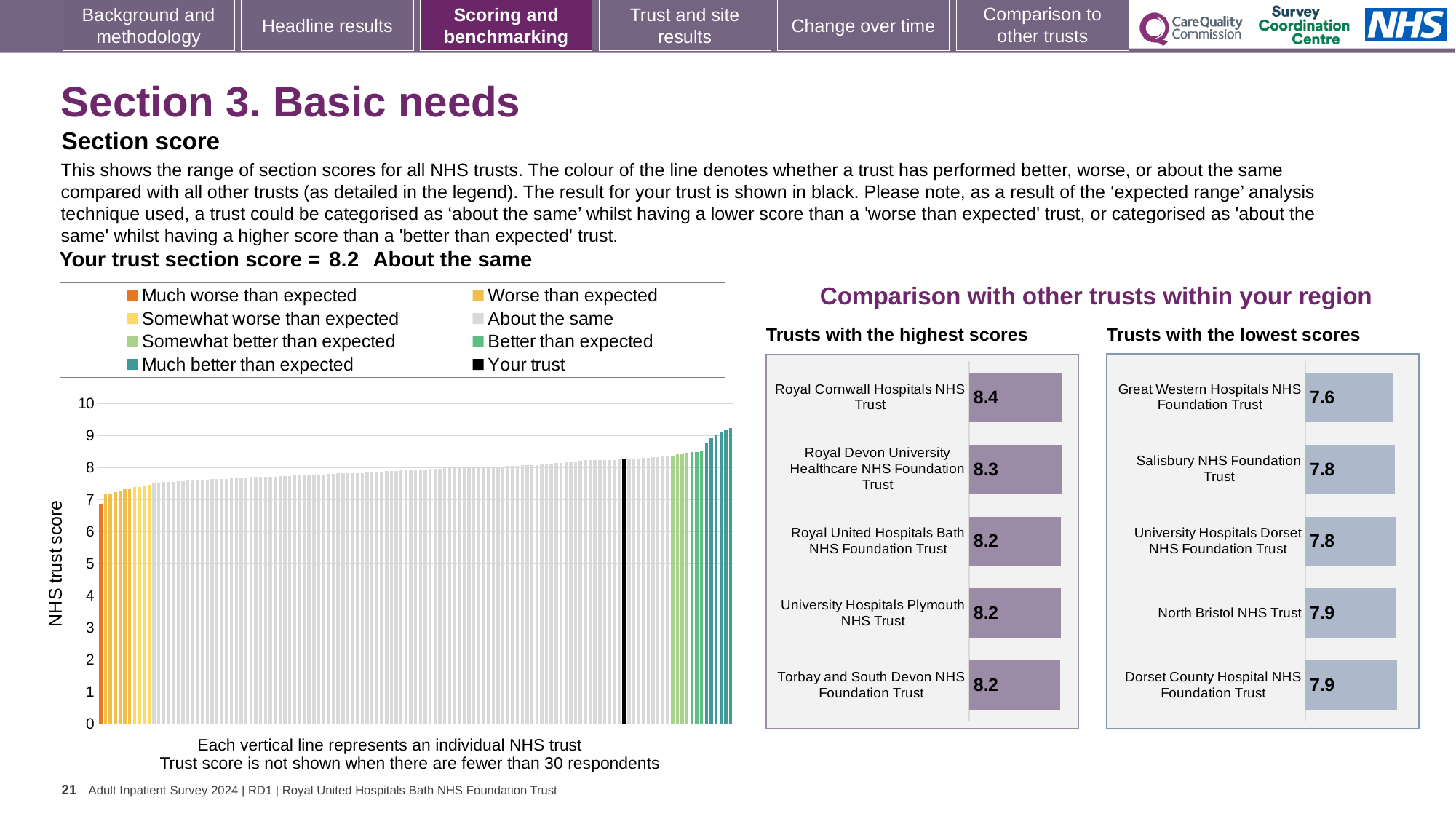
In the 'Trusts with the highest scores' chart, what is the difference between the scores of Royal Cornwall Hospitals NHS Trust and Torbay and South Devon NHS Foundation Trust? 0.2 How many trusts are shown in the 'Trusts with the lowest scores' chart? 5 In the 'Trusts with the lowest scores' chart, what is the score for Great Western Hospitals NHS Foundation Trust? 7.6 In the 'Trusts with the lowest scores' chart, which trust has the lowest score? Great Western Hospitals NHS Foundation Trust In the NHS trust score chart on the left, do the bar values rise or fall from left to right? Rise How many entries does the legend of the NHS trust score chart on the left list? 8 In the 'Trusts with the highest scores' chart, what is the score for Royal Devon University Healthcare NHS Foundation Trust? 8.3 In the 'Trusts with the highest scores' chart, which trust has the highest score? Royal Cornwall Hospitals NHS Trust In the 'Trusts with the lowest scores' chart, which has the larger score: Salisbury NHS Foundation Trust or Great Western Hospitals NHS Foundation Trust? Salisbury NHS Foundation Trust What kind of chart is the NHS trust score chart on the left of the slide? Bar chart In the 'Trusts with the lowest scores' chart, what is the score for North Bristol NHS Trust? 7.9 In the 'Trusts with the highest scores' chart, what is the score for Royal Cornwall Hospitals NHS Trust? 8.4